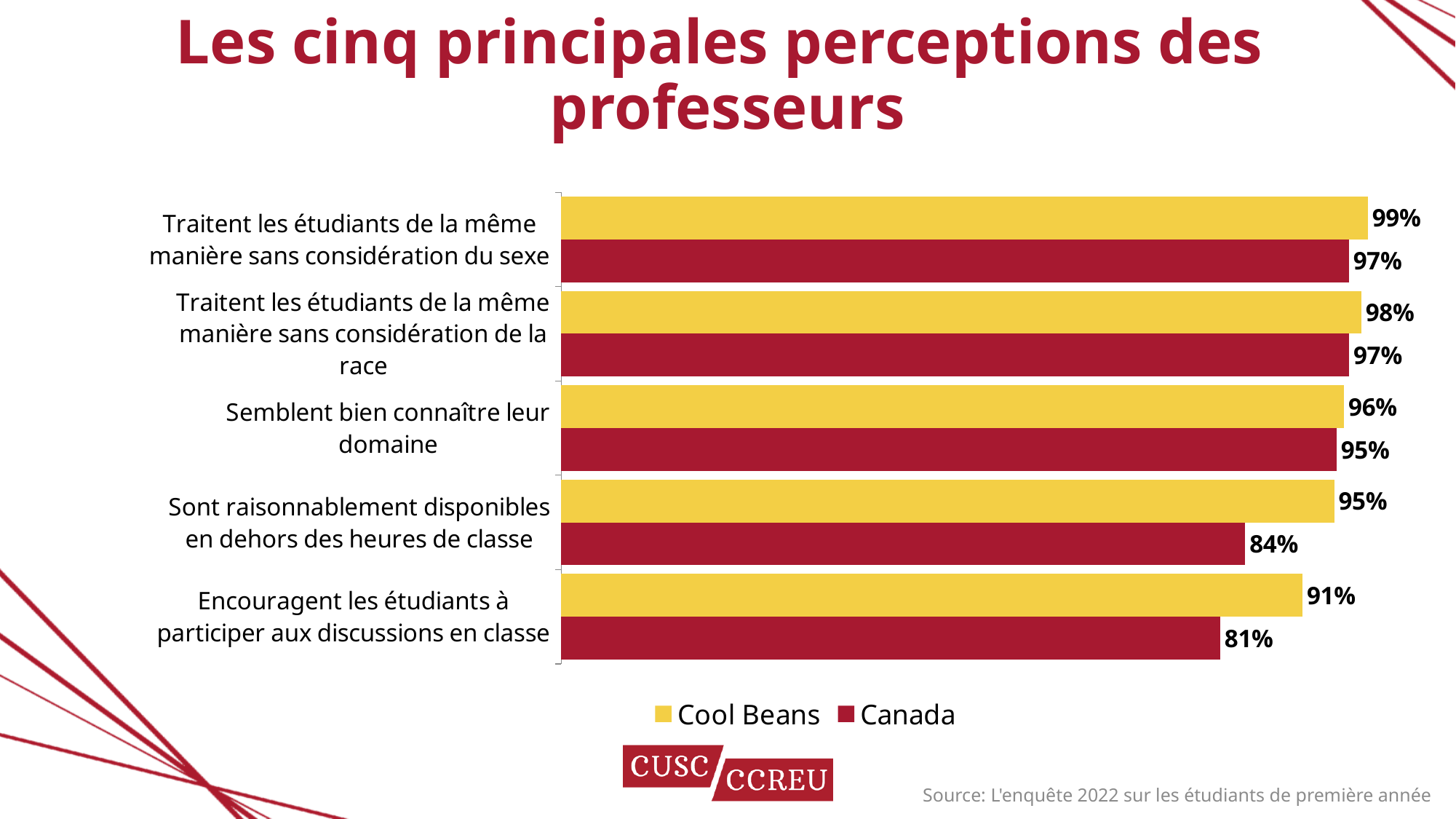
Which is larger for "Semblent bien connaître leur domaine": the Cool Beans value or the Canada value? Cool Beans What is the difference between the Cool Beans and Canada values for "Encouragent les étudiants à participer aux discussions en classe"? 10% What is the Cool Beans value for "Semblent bien connaître leur domaine"? 96% How many series does the legend list? 2 What kind of chart is shown on the slide? Bar chart What is the difference between the Cool Beans and Canada values for "Sont raisonnablement disponibles en dehors des heures de classe"? 11% How many categories are shown in the chart? 5 What is the Canada value for "Encouragent les étudiants à participer aux discussions en classe"? 81% What is the Cool Beans value for "Traitent les étudiants de la même manière sans considération du sexe"? 99% Which category has the highest Cool Beans value? Traitent les étudiants de la même manière sans considération du sexe Which category has the lowest Canada value? Encouragent les étudiants à participer aux discussions en classe What is the Canada value for "Sont raisonnablement disponibles en dehors des heures de classe"? 84%